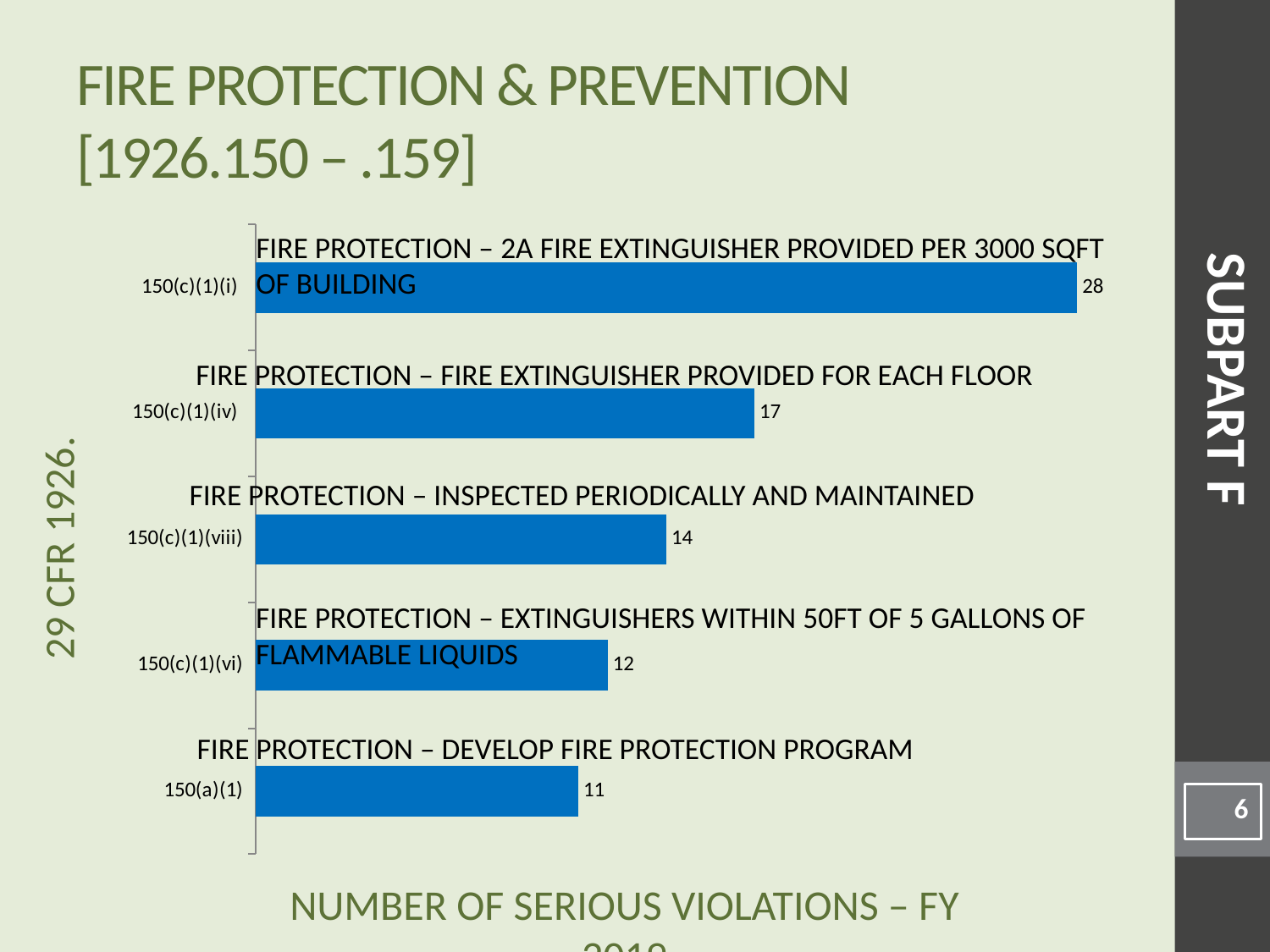
Which standard has the lowest number of serious violations? 150(a)(1) What is the number of serious violations for 150(c)(1)(i)? 28 What is the total number of serious violations across all five standards shown? 82 What kind of chart is shown on the slide? Bar chart What is the number of serious violations for 150(a)(1)? 11 Which standard has the highest number of serious violations? 150(c)(1)(i) What is the difference in serious violations between 150(c)(1)(i) and 150(c)(1)(iv)? 11 What is the description shown for the bar labelled 150(a)(1)? FIRE PROTECTION – DEVELOP FIRE PROTECTION PROGRAM What is the number of serious violations for 150(c)(1)(iv)? 17 What is the number of serious violations for 150(c)(1)(viii)? 14 Which has more serious violations, 150(c)(1)(vi) or 150(c)(1)(viii)? 150(c)(1)(viii) How many standards are shown in the chart? 5